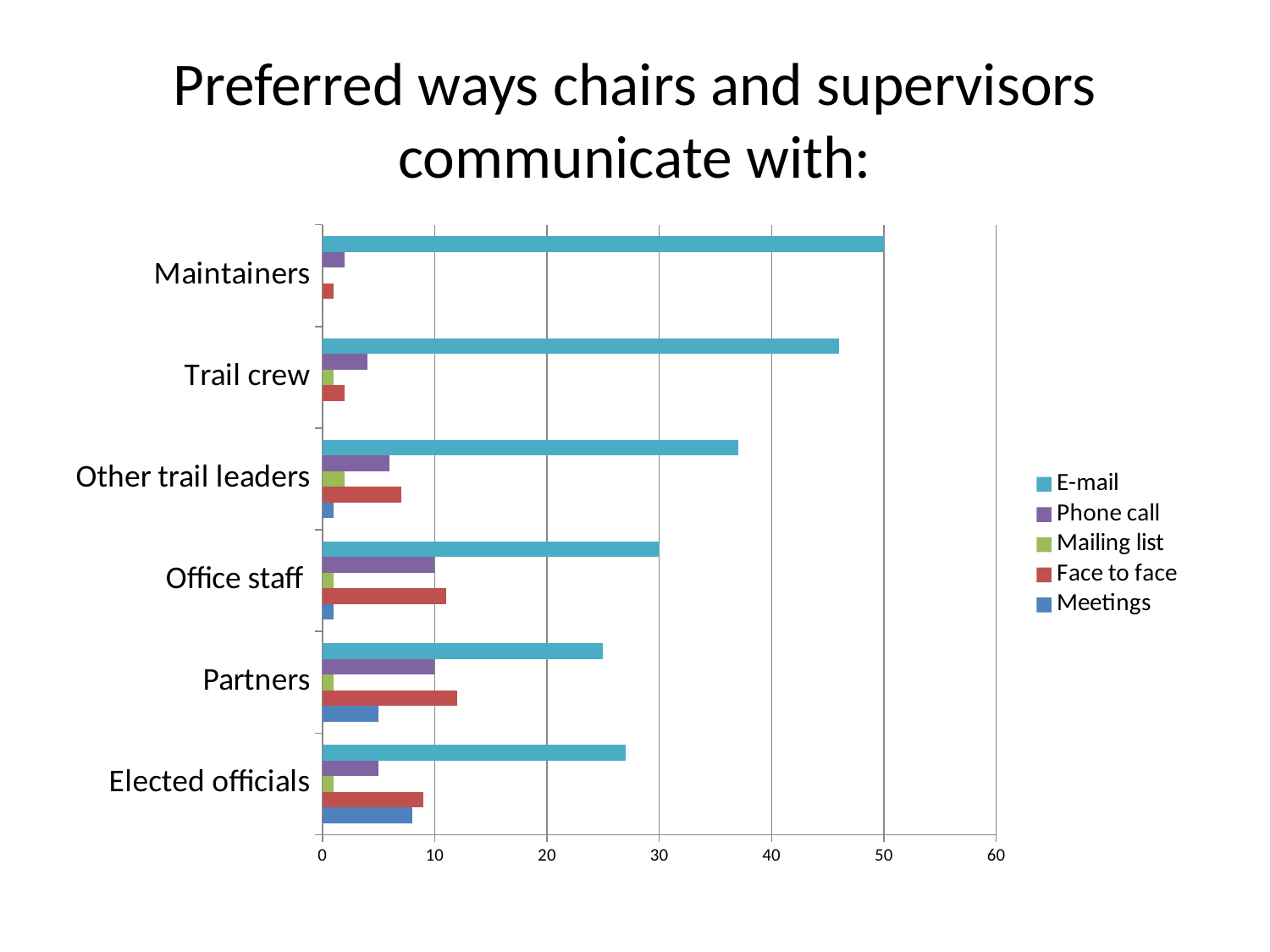
Is the Face to face value for Partners greater or less than 10? greater What is the E-mail value for Maintainers? 50 How many series does the legend list? 5 Which is larger for Elected officials, the Face to face value or the Phone call value? Face to face What is the Phone call value for Office staff? 10 Which category has the highest E-mail value? Maintainers Which category has the lowest E-mail value? Partners How many categories are shown on the vertical axis? 6 What type of chart is shown on the slide? bar chart Is the E-mail value for Trail crew greater or less than 40? greater What is the E-mail value for Office staff? 30 Which series is shown in red in the legend? Face to face